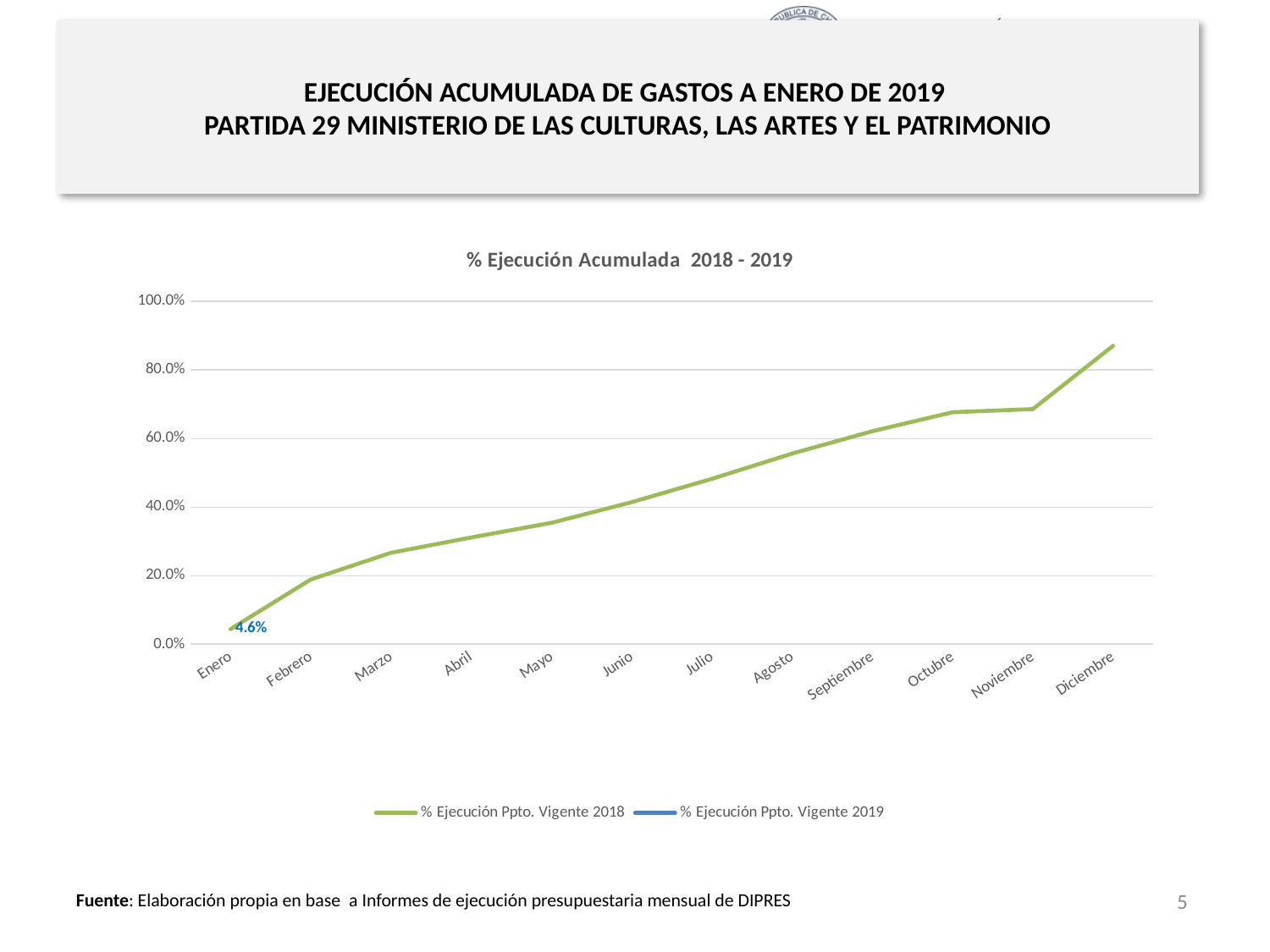
What kind of chart is shown on the slide? line chart In which month is the % Ejecución Ppto. Vigente 2018 line lowest? Enero In which month is the % Ejecución Ppto. Vigente 2018 line highest? Diciembre Does the % Ejecución Ppto. Vigente 2018 line rise or fall from Enero to Diciembre? rise Is the value for % Ejecución Ppto. Vigente 2018 in Marzo greater or less than 40.0%? less What is the value labelled for % Ejecución Ppto. Vigente 2019 in Enero? 4.6% For % Ejecución Ppto. Vigente 2018, which month has the larger value, Abril or Julio? Julio How many series does the legend list? 2 How many months are shown on the x axis? 12 Is the value for % Ejecución Ppto. Vigente 2018 in Octubre greater or less than 60.0%? greater Is the value for % Ejecución Ppto. Vigente 2018 in Diciembre greater or less than 80.0%? greater What is the title of the chart? % Ejecución Acumulada 2018 - 2019